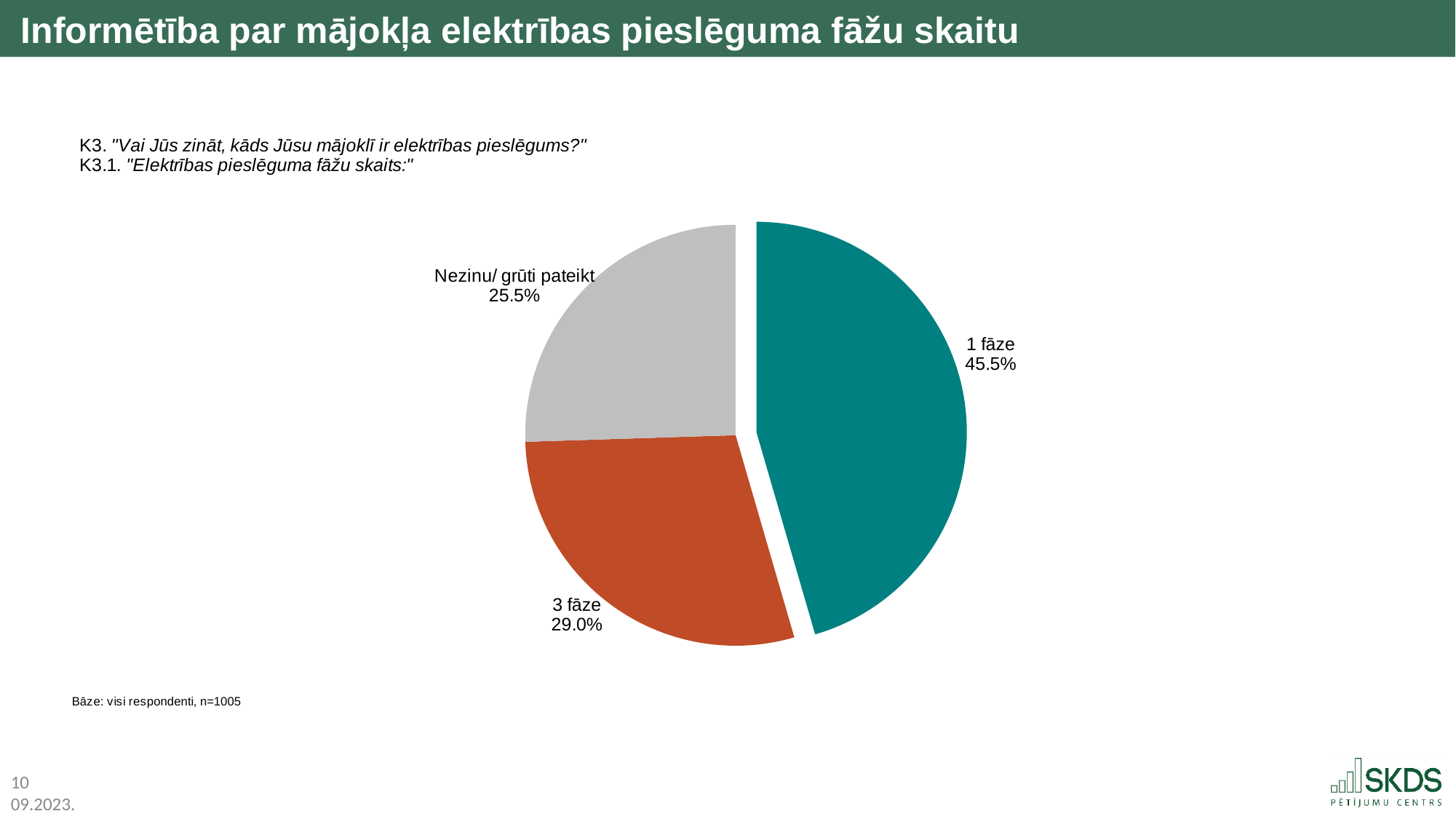
What is the difference in percentage points between "3 fāze" and "Nezinu/ grūti pateikt"? 3.5 Which category has the smallest share of the pie? Nezinu/ grūti pateikt What colour is the slice for "3 fāze"? Orange-red How many slices does the pie chart have? 3 What share of respondents answered "1 fāze"? 45.5% Which category has the largest share of the pie? 1 fāze What kind of chart is shown on the slide? Pie chart What is the difference in percentage points between "1 fāze" and "3 fāze"? 16.5 What share of respondents answered "3 fāze"? 29.0% What share of respondents answered "Nezinu/ grūti pateikt"? 25.5% What is the combined share of "1 fāze" and "3 fāze"? 74.5% Which is larger, the share for "1 fāze" or the share for "Nezinu/ grūti pateikt"? 1 fāze